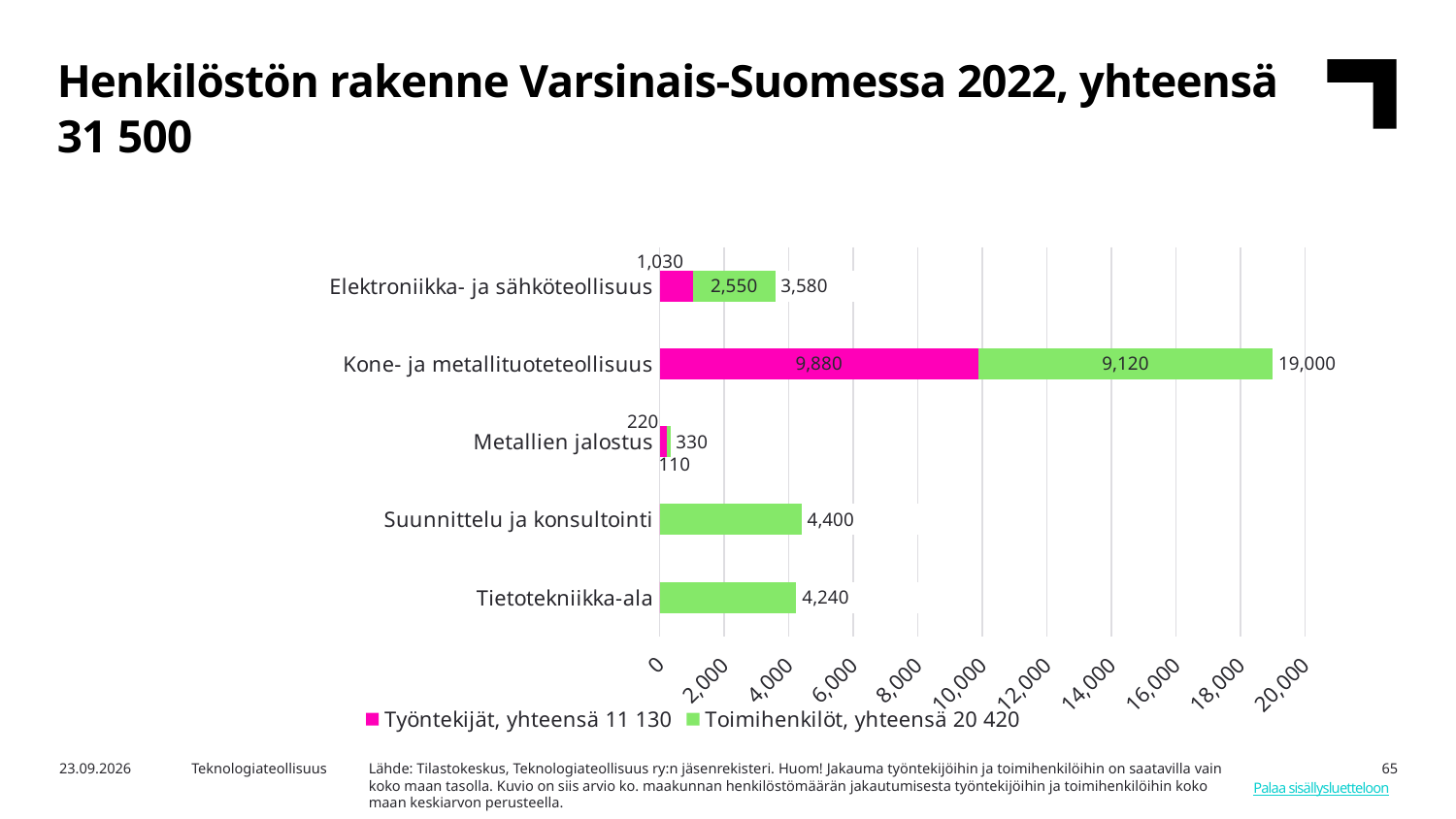
How many categories are shown on the chart? 5 What is the difference between the totals of Suunnittelu ja konsultointi and Tietotekniikka-ala? 160 What is the Työntekijät value for Kone- ja metallituoteteollisuus? 9,880 What is the total for Metallien jalostus? 330 Which category has the lowest total? Metallien jalostus Which category has the highest total? Kone- ja metallituoteteollisuus How many series does the legend list? 2 What is the total for Kone- ja metallituoteteollisuus? 19,000 Which is larger, the Työntekijät value or the Toimihenkilöt value for Kone- ja metallituoteteollisuus? Työntekijät What total is given for Toimihenkilöt in the legend? 20 420 What type of chart is shown on the slide? Stacked bar chart What is the Toimihenkilöt value for Elektroniikka- ja sähköteollisuus? 2,550